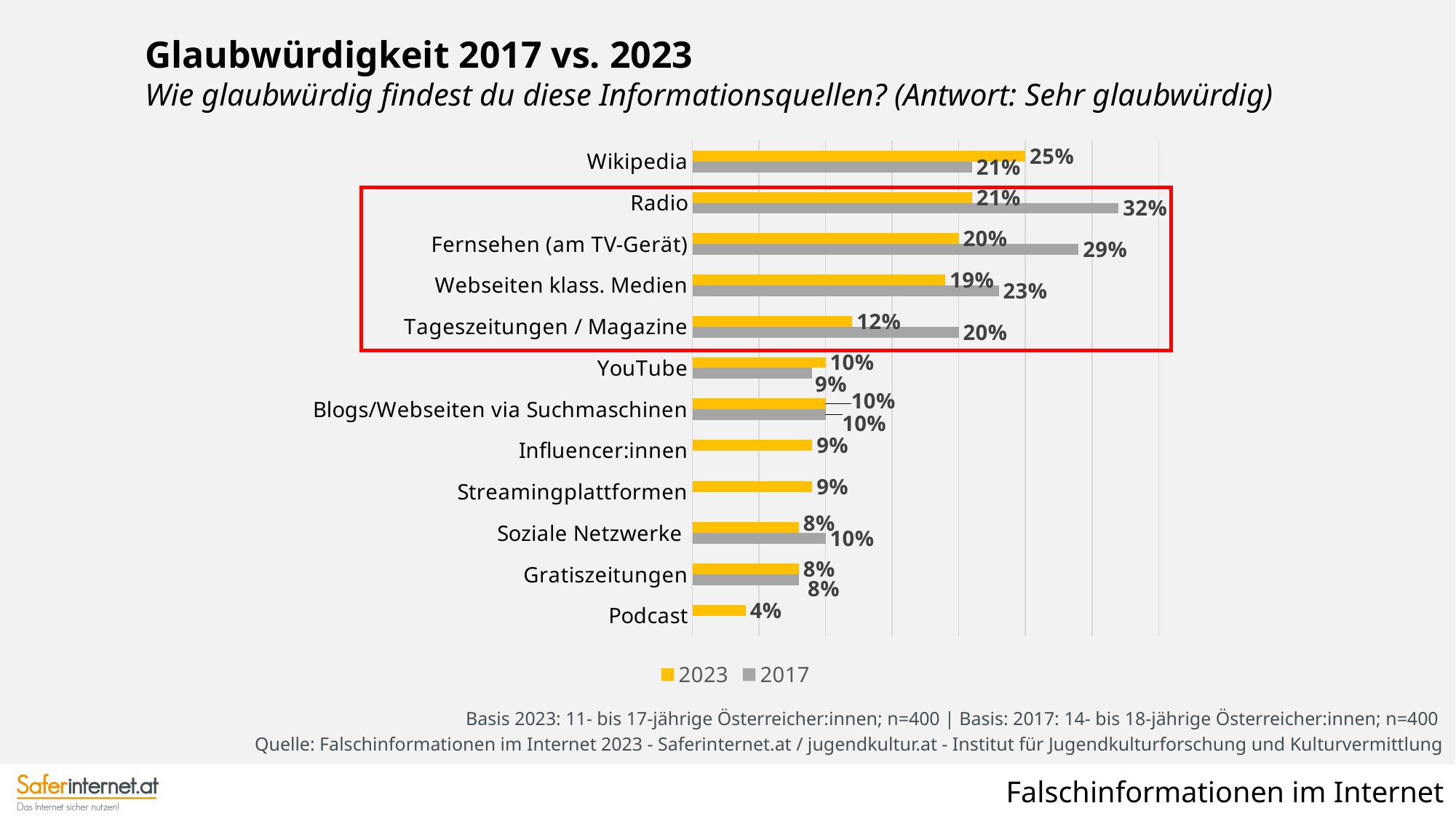
For Wikipedia, which is larger: the 2023 value or the 2017 value? 2023 What is the difference between the 2017 and 2023 values for Fernsehen (am TV-Gerät)? 9% How many categories (information sources) are shown in the chart? 12 Which category has the highest 2023 value? Wikipedia How many series does the legend list? 2 Which category has the highest 2017 value? Radio What kind of chart is shown on the slide? bar chart What is the 2023 value for Wikipedia? 25% What is the 2023 value for Tageszeitungen / Magazine? 12% Which category has the lowest 2023 value? Podcast What is the 2017 value for Radio? 32% Which colour represents the 2017 series in the chart? grey